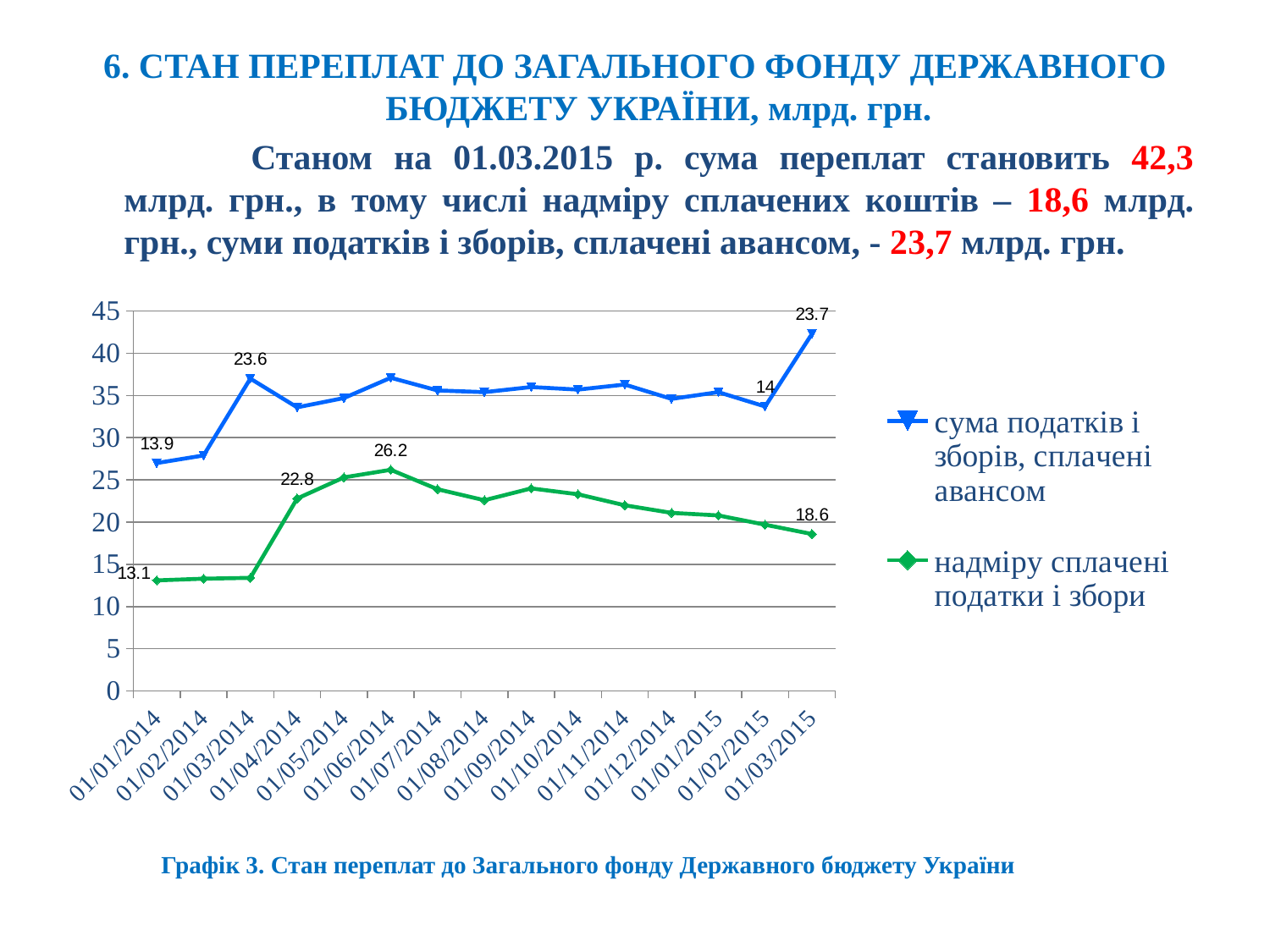
On which date does the 'надміру сплачені податки і збори' series reach its highest value? 01/06/2014 How many dates are plotted along the x axis? 15 What is the difference between the labelled values of 'надміру сплачені податки і збори' on 01/06/2014 and 01/04/2014? 3.4 What kind of chart is shown on the slide? line chart Does the 'надміру сплачені податки і збори' series rise or fall from 01/06/2014 to 01/03/2015? fall How many series does the legend list? 2 What is the labelled value for 'надміру сплачені податки і збори' on 01/06/2014? 26.2 What is the labelled value for 'надміру сплачені податки і збори' on 01/01/2014? 13.1 On 01/03/2015, which series has the larger labelled value: 'сума податків і зборів, сплачені авансом' or 'надміру сплачені податки і збори'? сума податків і зборів, сплачені авансом What is the difference between the labelled values of 'сума податків і зборів, сплачені авансом' on 01/03/2015 and 01/02/2015? 9.7 What is the labelled value for 'сума податків і зборів, сплачені авансом' on 01/03/2015? 23.7 What is the labelled value for 'сума податків і зборів, сплачені авансом' on 01/02/2015? 14